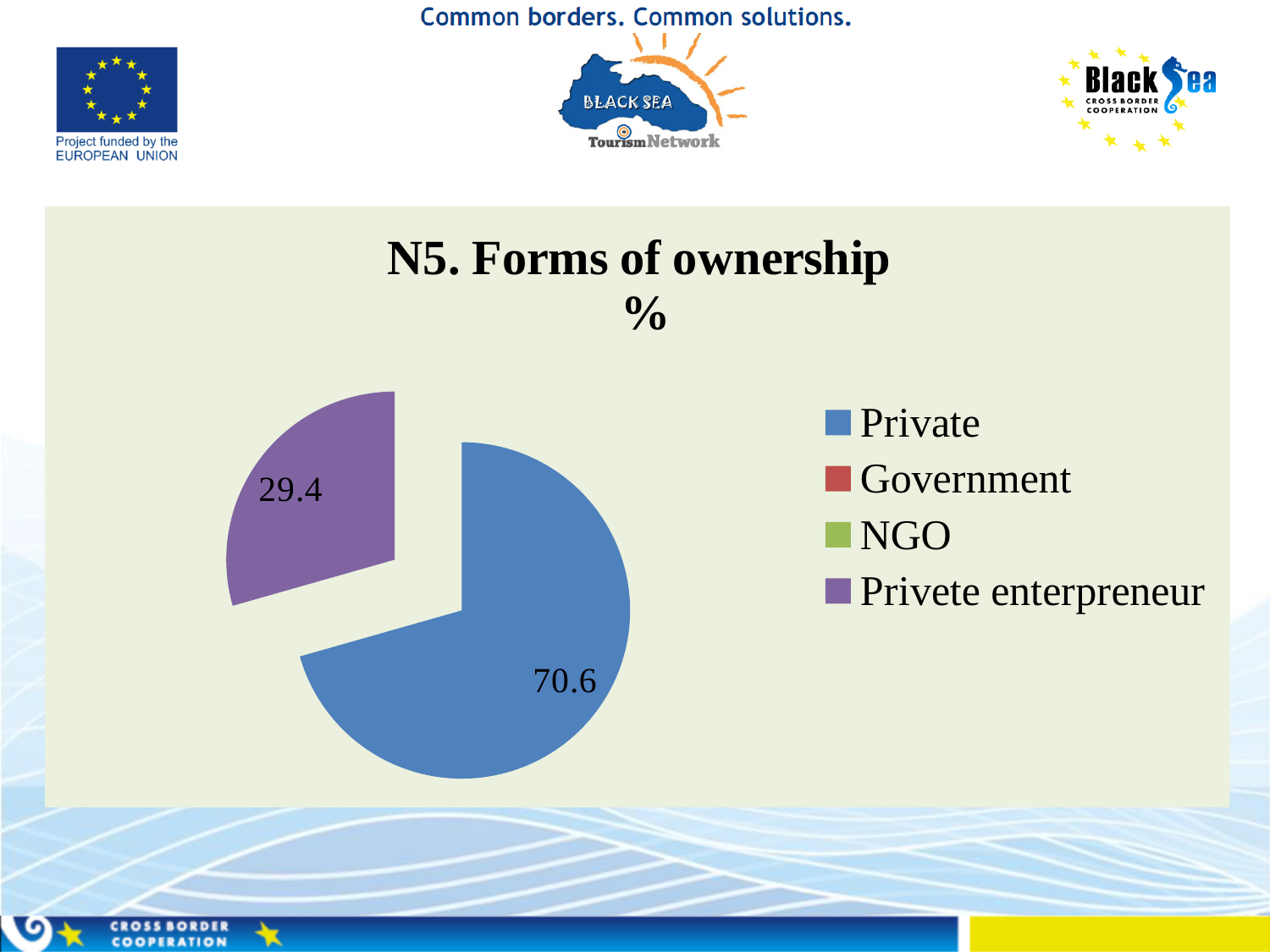
What is the value shown for the Private slice in the pie chart? 70.6 Which of the two labelled slices is smaller, Private or Privete enterpreneur? Privete enterpreneur What is the difference between the Private value and the Privete enterpreneur value? 41.2 Which category has the largest slice in the pie chart? Private What is the title of the chart? N5. Forms of ownership % How many categories does the legend of the pie chart list? 4 What is the value shown for the Privete enterpreneur slice in the pie chart? 29.4 Which legend entry is shown in purple? Privete enterpreneur What is the total of the two labelled slices in the pie chart? 100 Which is larger, the Private slice or the Privete enterpreneur slice? Private What kind of chart is shown on the slide? Pie chart How many slices with data labels are visible in the pie chart? 2